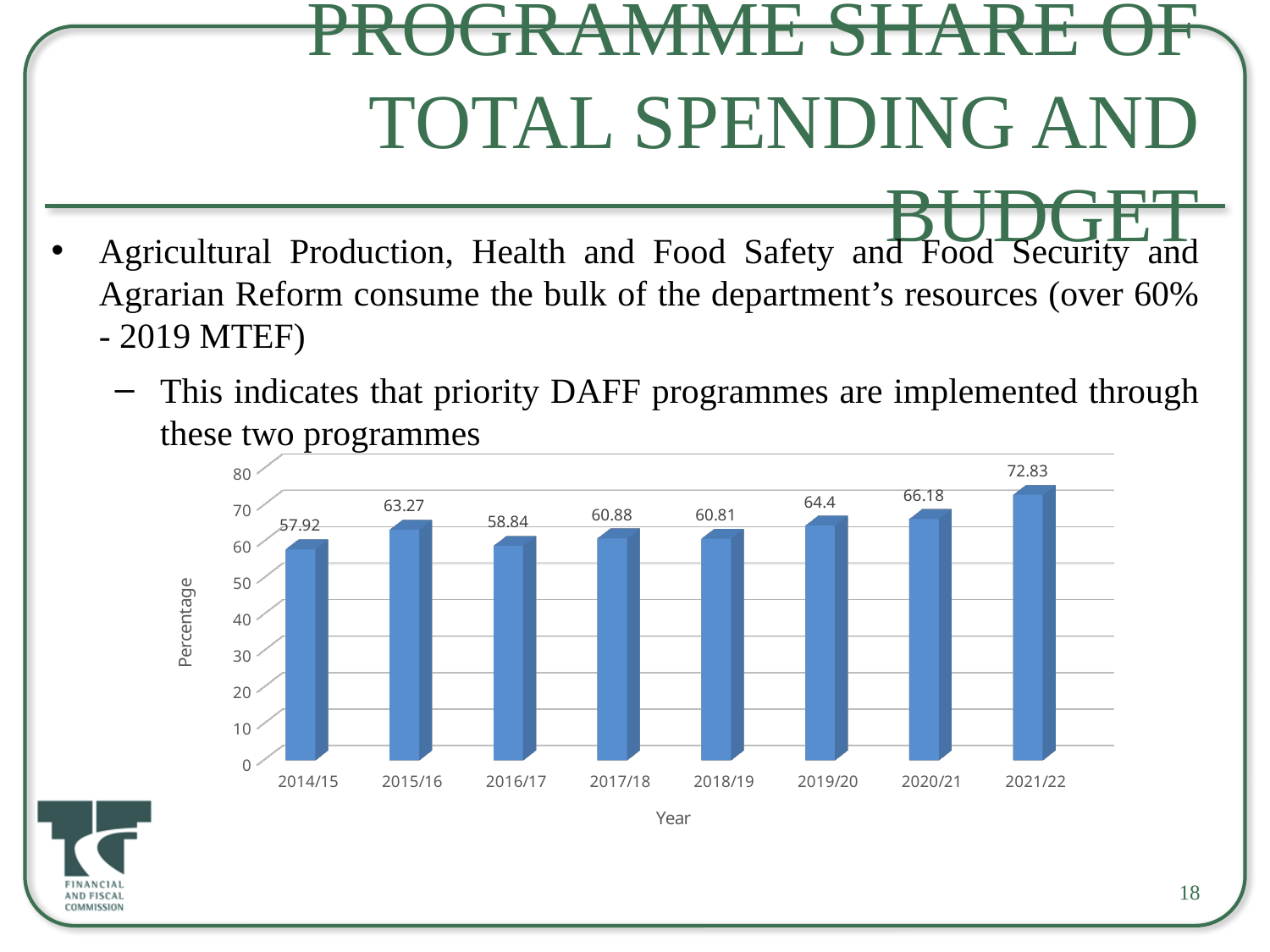
Which year has the highest percentage? 2021/22 What kind of chart is shown on the slide? bar chart Is the value for 2020/21 greater or less than 60? greater What is the percentage value for 2019/20? 64.4 What is the label of the vertical axis? Percentage Which year has the lowest percentage? 2014/15 What is the difference between the values for 2021/22 and 2014/15? 14.91 Do the values generally rise or fall from 2016/17 to 2021/22? rise What is the percentage value for 2021/22? 72.83 Which is larger, the value for 2015/16 or the value for 2016/17? 2015/16 What is the percentage value for 2014/15? 57.92 How many years are shown on the x axis? 8